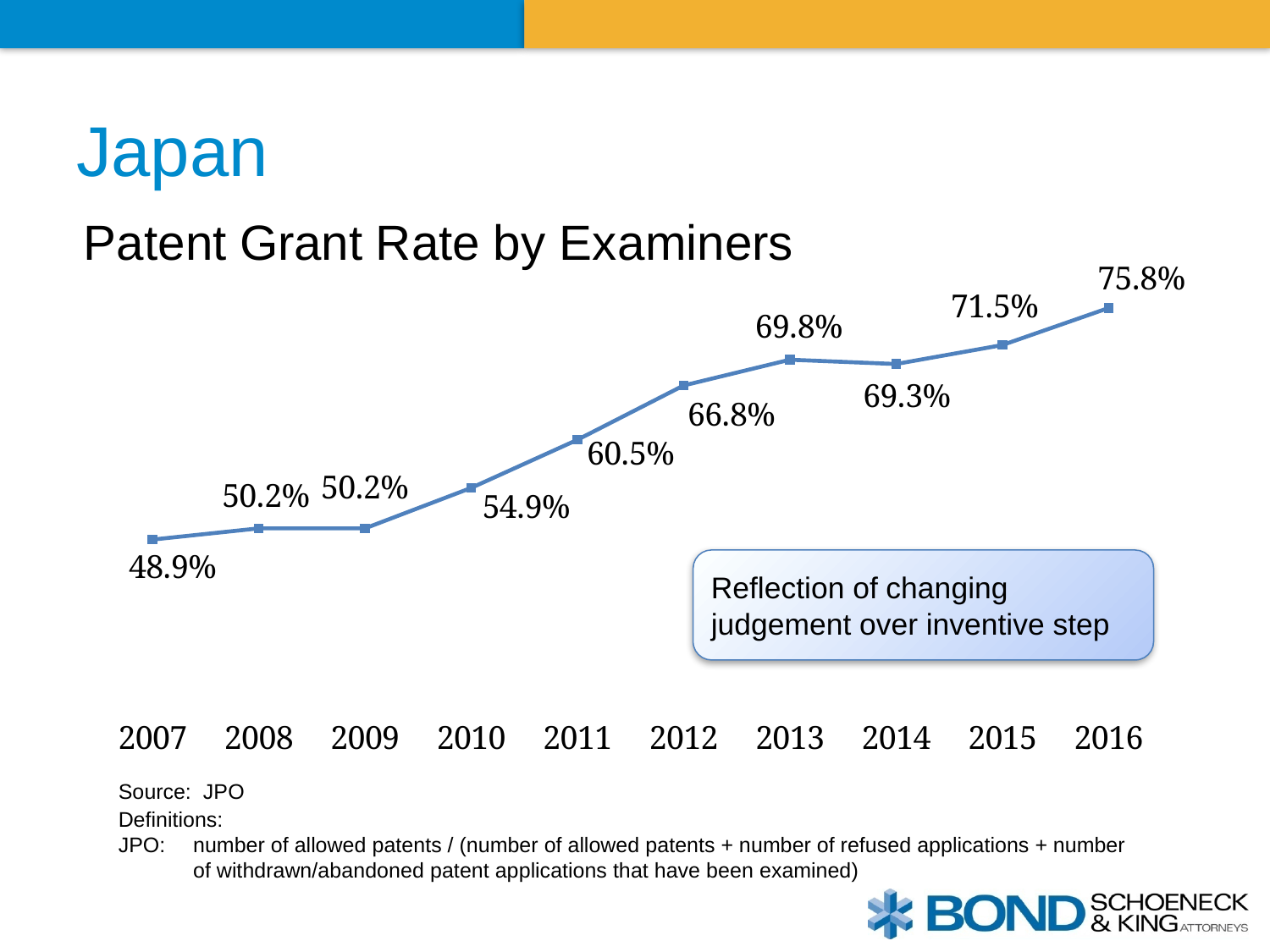
How many years are plotted on the chart? 10 What is the difference in patent grant rate between 2013 and 2014? 0.5% What was the patent grant rate in 2016? 75.8% What kind of chart is shown on the slide? Line chart Which year has the highest patent grant rate? 2016 Which year has the lowest patent grant rate? 2007 What is the overall trend of the patent grant rate from 2007 to 2016? Rising Which year had a higher patent grant rate, 2012 or 2015? 2015 What was the patent grant rate in 2007? 48.9% What is the difference in patent grant rate between 2016 and 2007? 26.9% What was the patent grant rate in 2011? 60.5% What was the patent grant rate in 2014? 69.3%